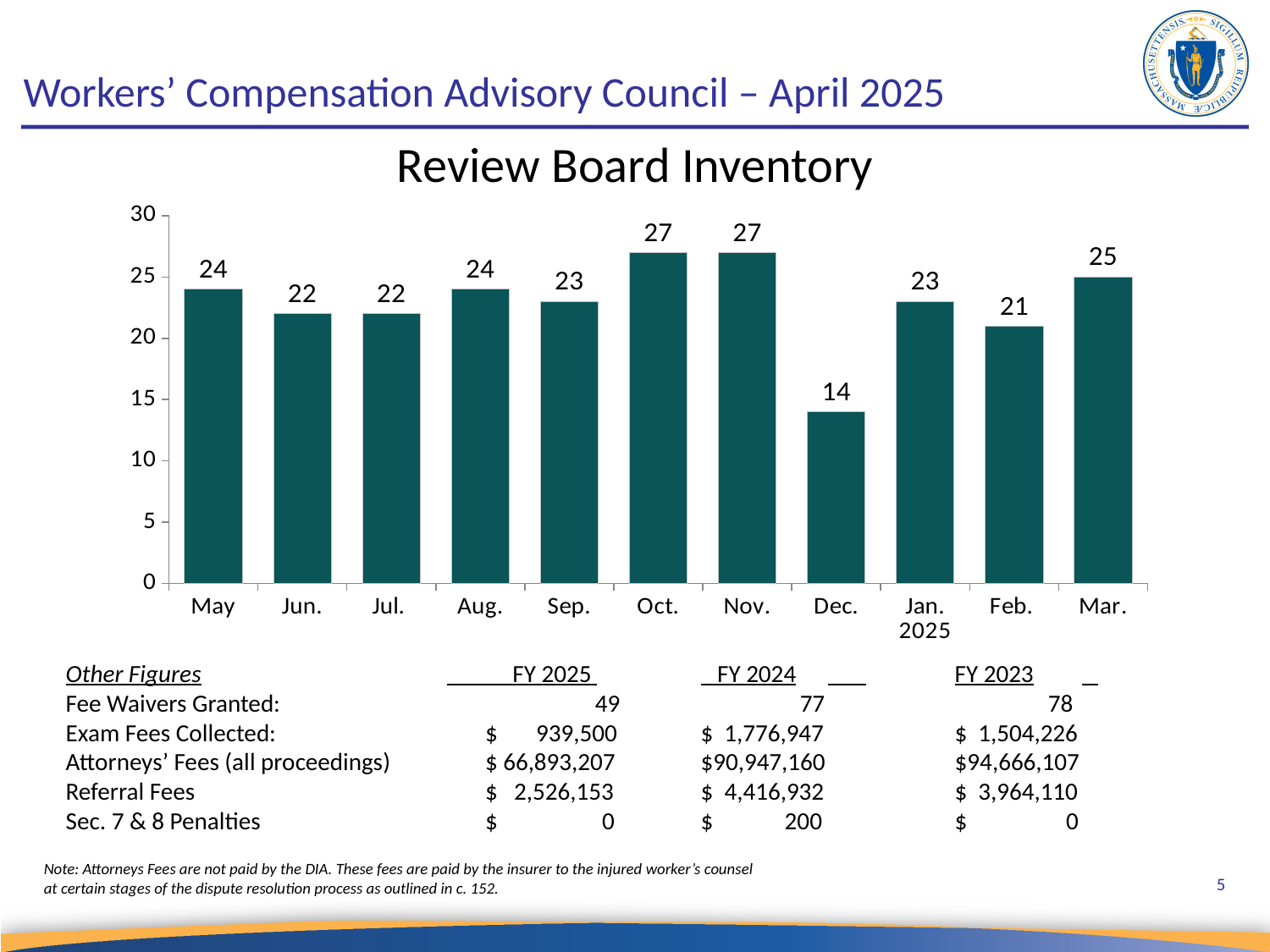
Which month has the lowest Review Board Inventory? Dec. What is the title of the chart on the slide? Review Board Inventory Which is larger, the Review Board Inventory for May or for Jun.? May Is the Review Board Inventory value for Dec. greater or less than 15? less What is the Review Board Inventory value for Dec.? 14 How many months are shown on the Review Board Inventory chart? 11 Which months share the highest Review Board Inventory value? Oct. and Nov. Does the Review Board Inventory rise or fall from Dec. to Jan. 2025? rise What is the Review Board Inventory value for Mar.? 25 What is the Review Board Inventory value for Feb.? 21 What is the difference between the Review Board Inventory for Oct. and Dec.? 13 What type of chart is the Review Board Inventory chart? bar chart